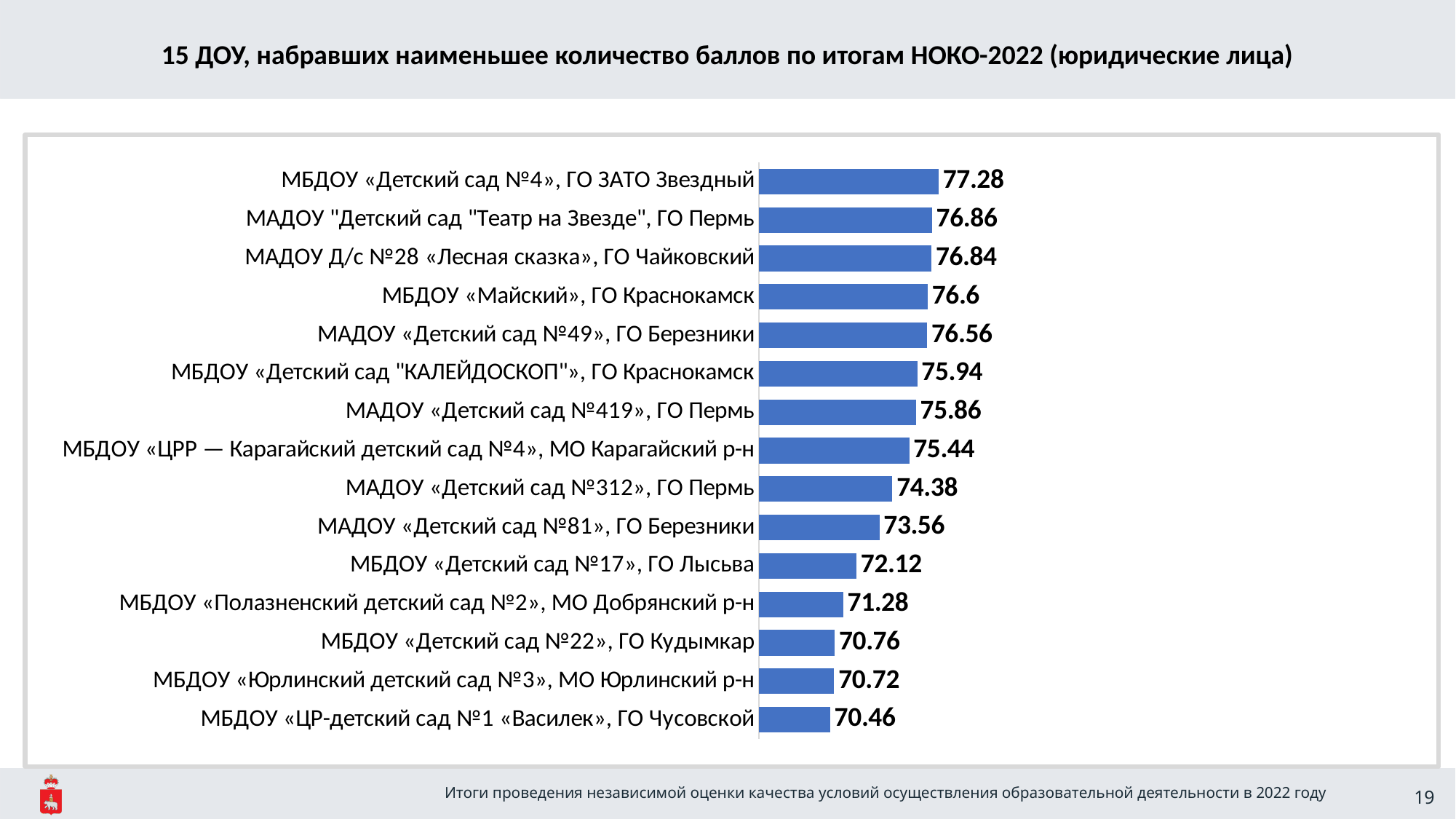
What is the difference between the highest score (77.28) and the lowest score (70.46)? 6.82 What is the difference between the scores of МАДОУ «Детский сад №312», ГО Пермь and МАДОУ «Детский сад №81», ГО Березники? 0.82 What value is shown for МБДОУ «Детский сад №17», ГО Лысьва? 72.12 What score is shown for МБДОУ «Детский сад №4», ГО ЗАТО Звездный? 77.28 What type of chart is shown on the slide? Bar chart Do the values increase or decrease going from the top bar to the bottom bar? Decrease What value is shown for МАДОУ «Детский сад №312», ГО Пермь? 74.38 Which organisation has the highest score on the chart? МБДОУ «Детский сад №4», ГО ЗАТО Звездный Which has a higher score: МБДОУ «Детский сад №22», ГО Кудымкар or МАДОУ «Детский сад №49», ГО Березники? МАДОУ «Детский сад №49», ГО Березники Which organisation has the lowest score on the chart? МБДОУ «ЦР-детский сад №1 «Василек», ГО Чусовской How many organisations are shown on the chart? 15 What value is shown for МБДОУ «Майский», ГО Краснокамск? 76.6